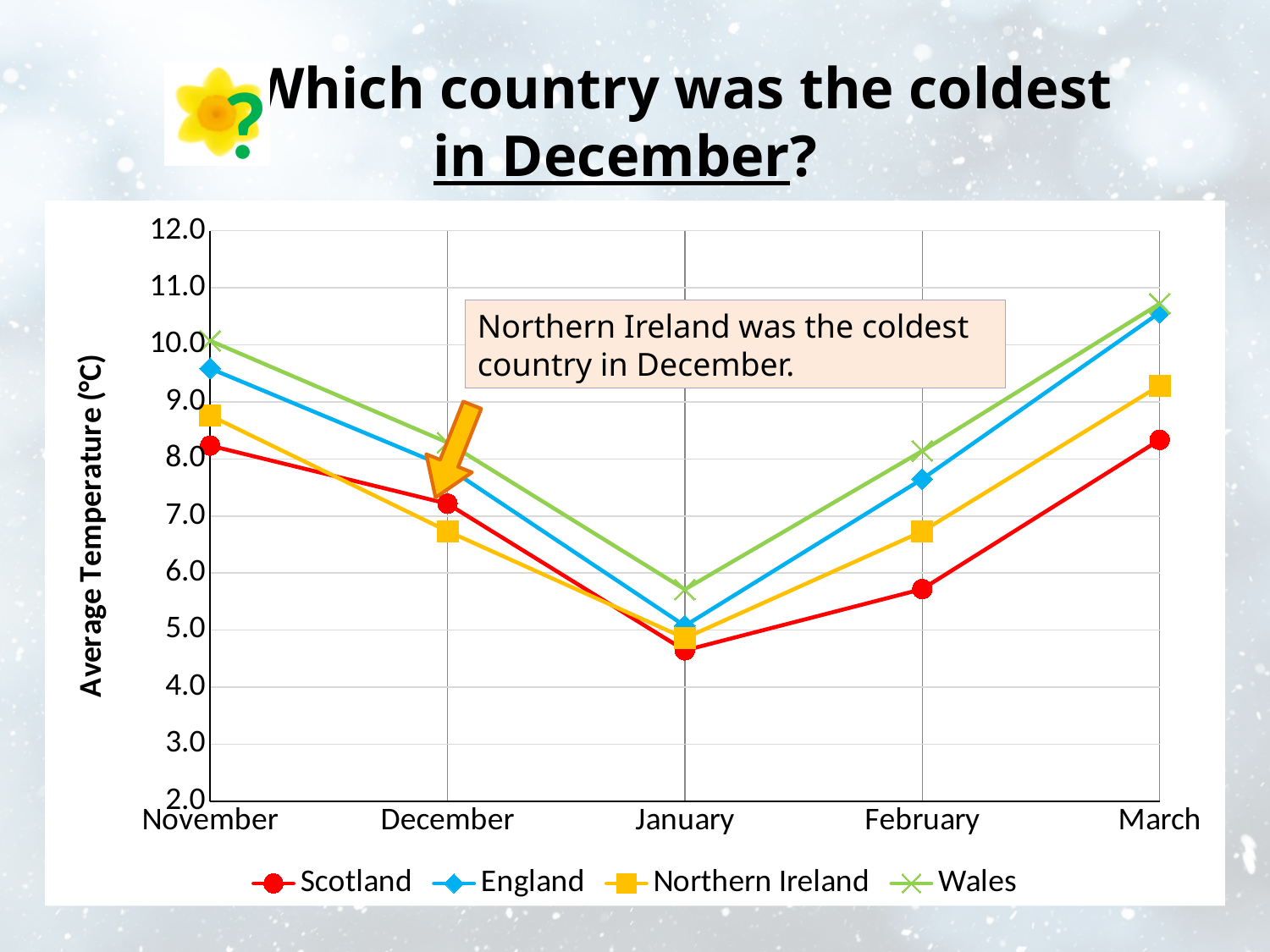
What is the title of the vertical axis? Average Temperature (°C) Is the average temperature for Wales in March greater or less than 10.0? greater Does the average temperature for Scotland rise or fall from November to January? fall Which country had the lowest average temperature in February? Scotland How many countries (series) does the legend list? 4 Which country had the highest average temperature in November? Wales Is the average temperature for Scotland in February greater or less than 6.0? less What kind of chart is shown on the slide? line chart In December, which had the higher average temperature, Scotland or England? England How many months are shown along the x axis? 5 Is the average temperature for England in November greater or less than 9.0? greater Which country had the lowest average temperature in December? Northern Ireland